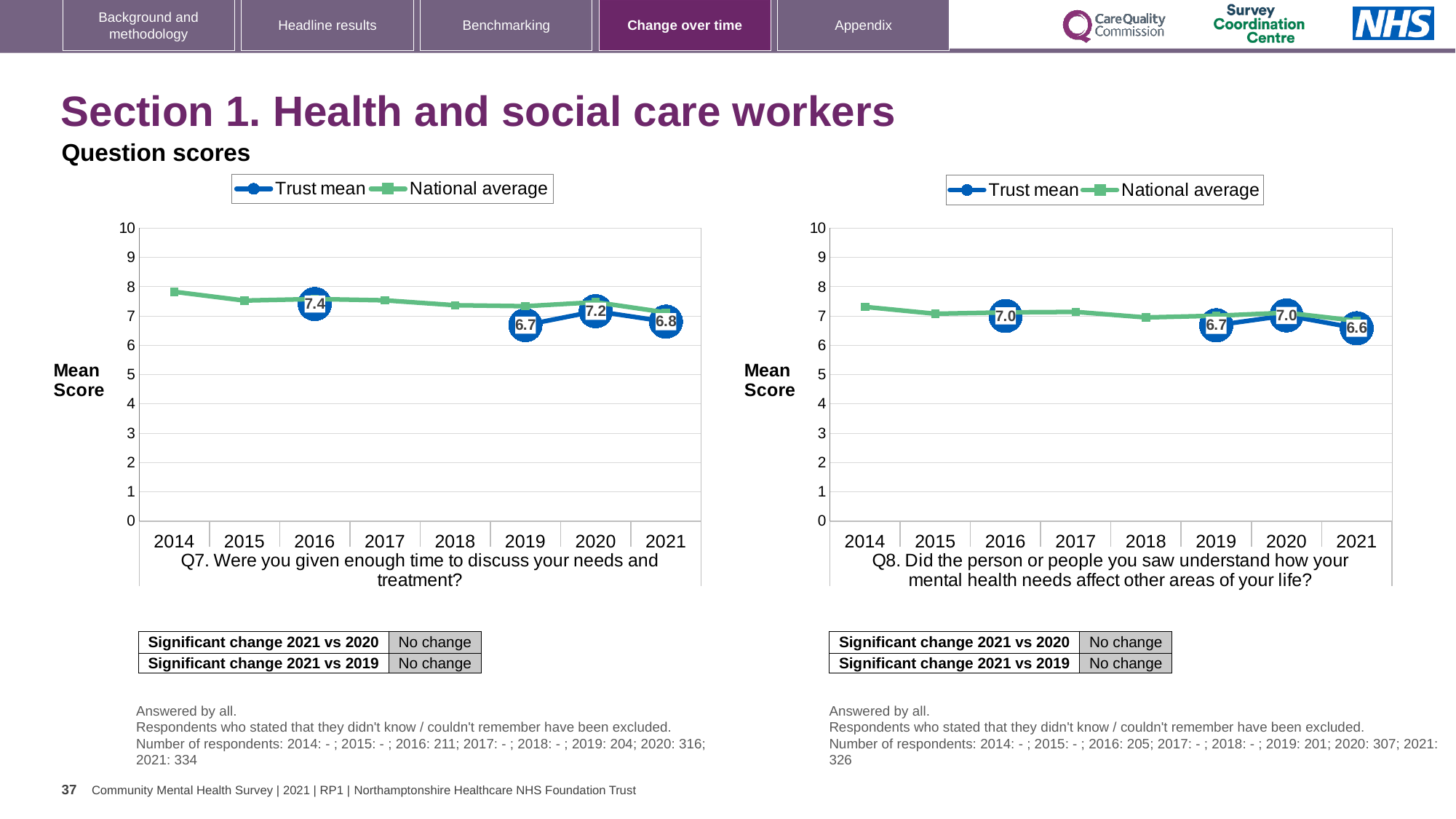
In the Q7 chart (left), what is the difference between the Trust mean in 2020 and in 2019? 0.5 How many series does the legend of the Q7 chart (left) list? 2 In the Q7 chart (left), which year has the highest labelled Trust mean? 2016 In the Q8 chart (right), is the Trust mean for 2020 larger or smaller than the Trust mean for 2021? larger How many years are shown on the x axis of the Q8 chart (right)? 8 In the Q8 chart (right), what is the Trust mean for 2021? 6.6 In the Q7 chart (left), what is the Trust mean for 2021? 6.8 What type of chart is used for Q7 (left)? Line chart In the Q7 chart (left), what is the Trust mean for 2016? 7.4 In the Q8 chart (right), which year has the lowest labelled Trust mean? 2021 In the Q7 chart (left), is the National average for 2014 greater or less than 7? greater In the Q8 chart (right), what is the Trust mean for 2019? 6.7